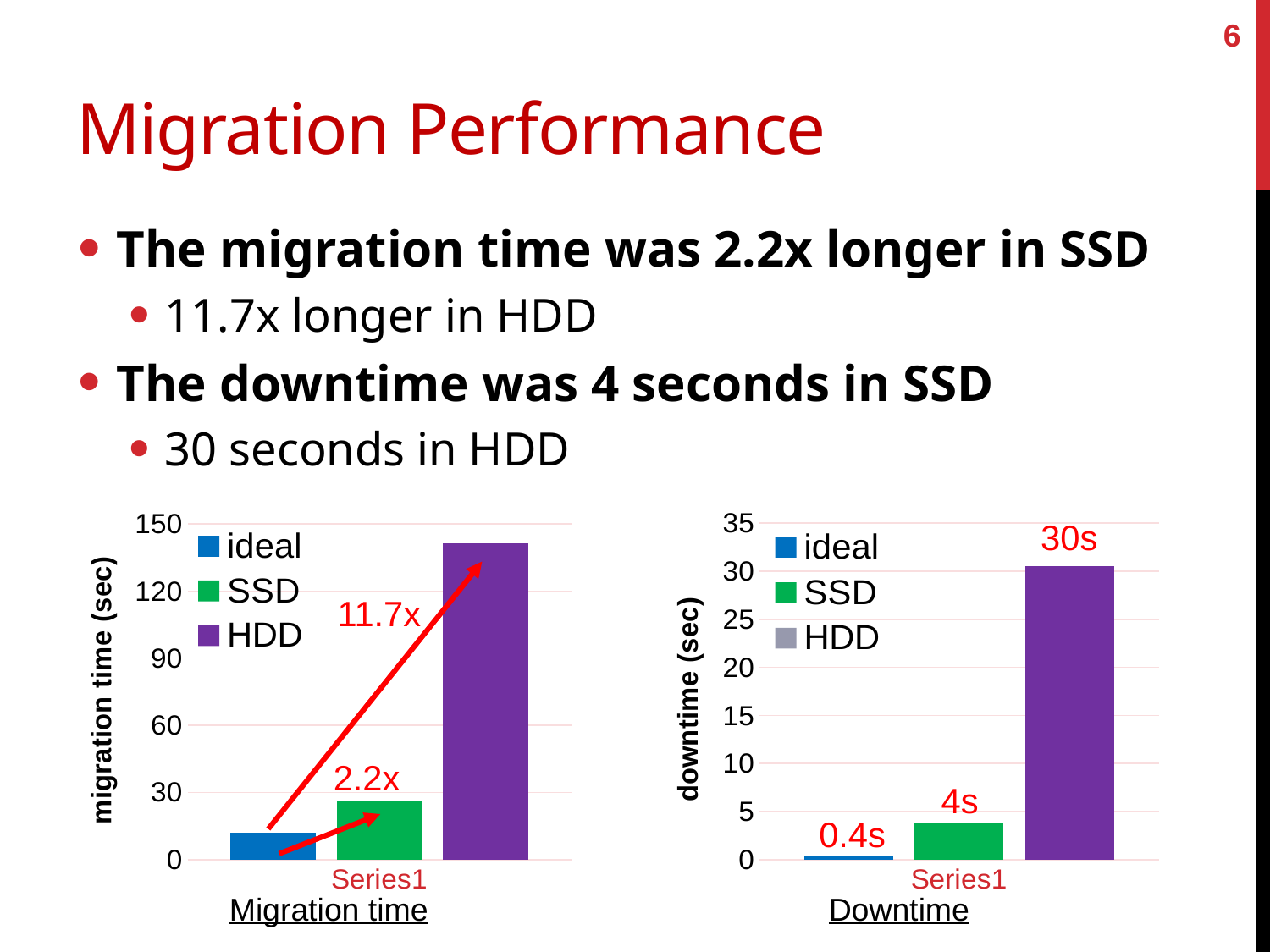
In the Migration time chart, which is larger, the migration time for SSD or for ideal? SSD In the Downtime chart, what is the downtime for ideal? 0.4s In the Downtime chart, what is the difference between the HDD and SSD downtimes? 26s In the Downtime chart, what is the downtime for HDD? 30s In the Migration time chart, is the migration time for HDD greater or less than 120? greater How many series does the legend of the Migration time chart list? 3 In the Downtime chart, which series has the highest downtime? HDD In the Migration time chart, is the migration time for SSD greater or less than 30? less In the Downtime chart, what is the downtime for SSD? 4s In the Migration time chart, which series has the highest migration time? HDD What kind of chart is the Downtime chart? bar chart In the Downtime chart, which series has the lowest downtime? ideal